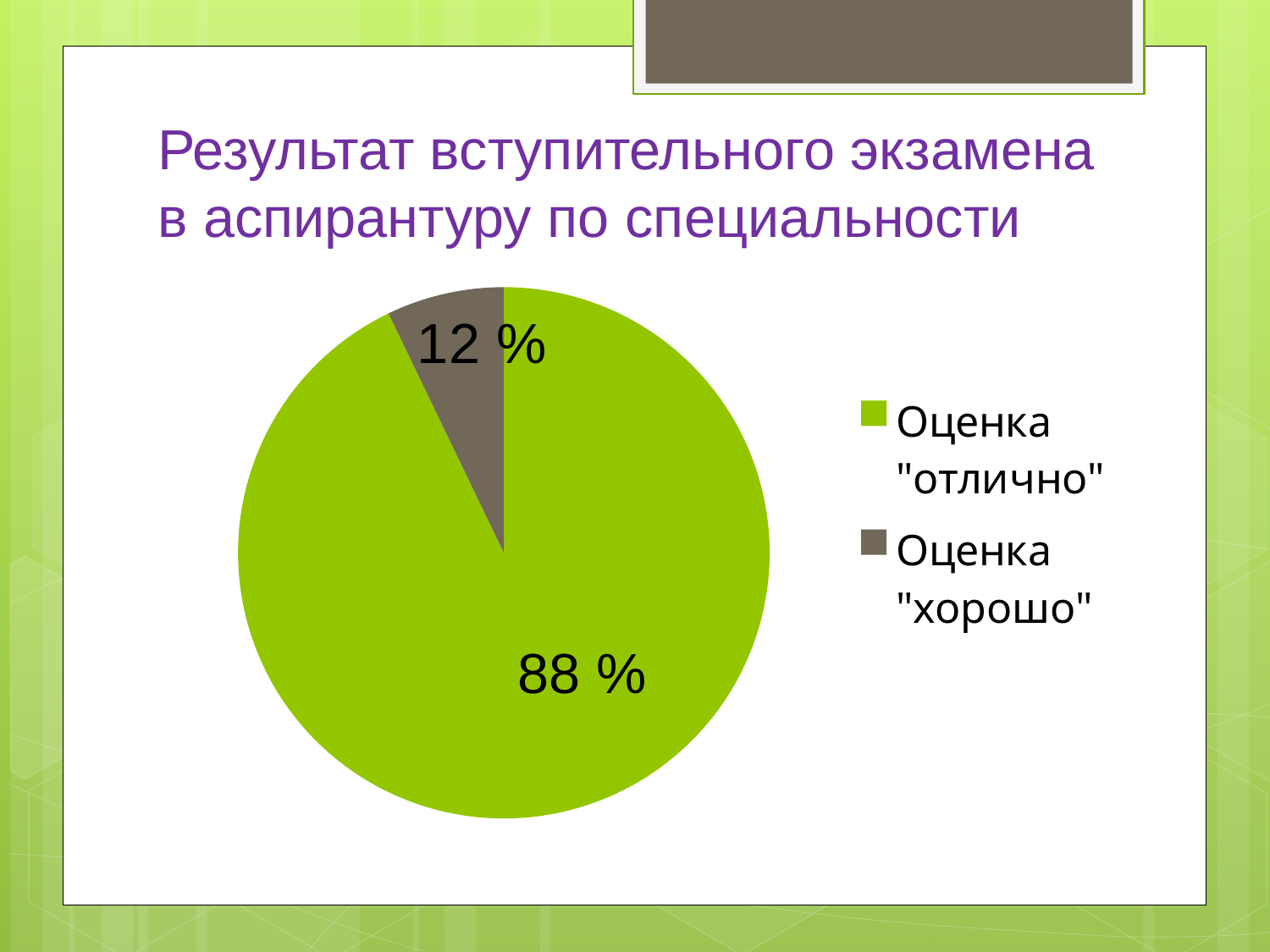
What share of the pie is labelled Оценка "хорошо"? 12 % What is the title of the slide containing the chart? Результат вступительного экзамена в аспирантуру по специальности How many entries does the legend list? 2 How many slices does the pie chart have? 2 What colour is the slice for Оценка "хорошо"? grey Which category has the smallest slice of the pie? Оценка "хорошо" What kind of chart is shown on the slide? pie chart What share of the pie is labelled Оценка "отлично"? 88 % Which category has the largest slice of the pie? Оценка "отлично" What is the difference in percentage points between the Оценка "отлично" slice and the Оценка "хорошо" slice? 76 Which is larger, the slice for Оценка "отлично" or the slice for Оценка "хорошо"? Оценка "отлично"